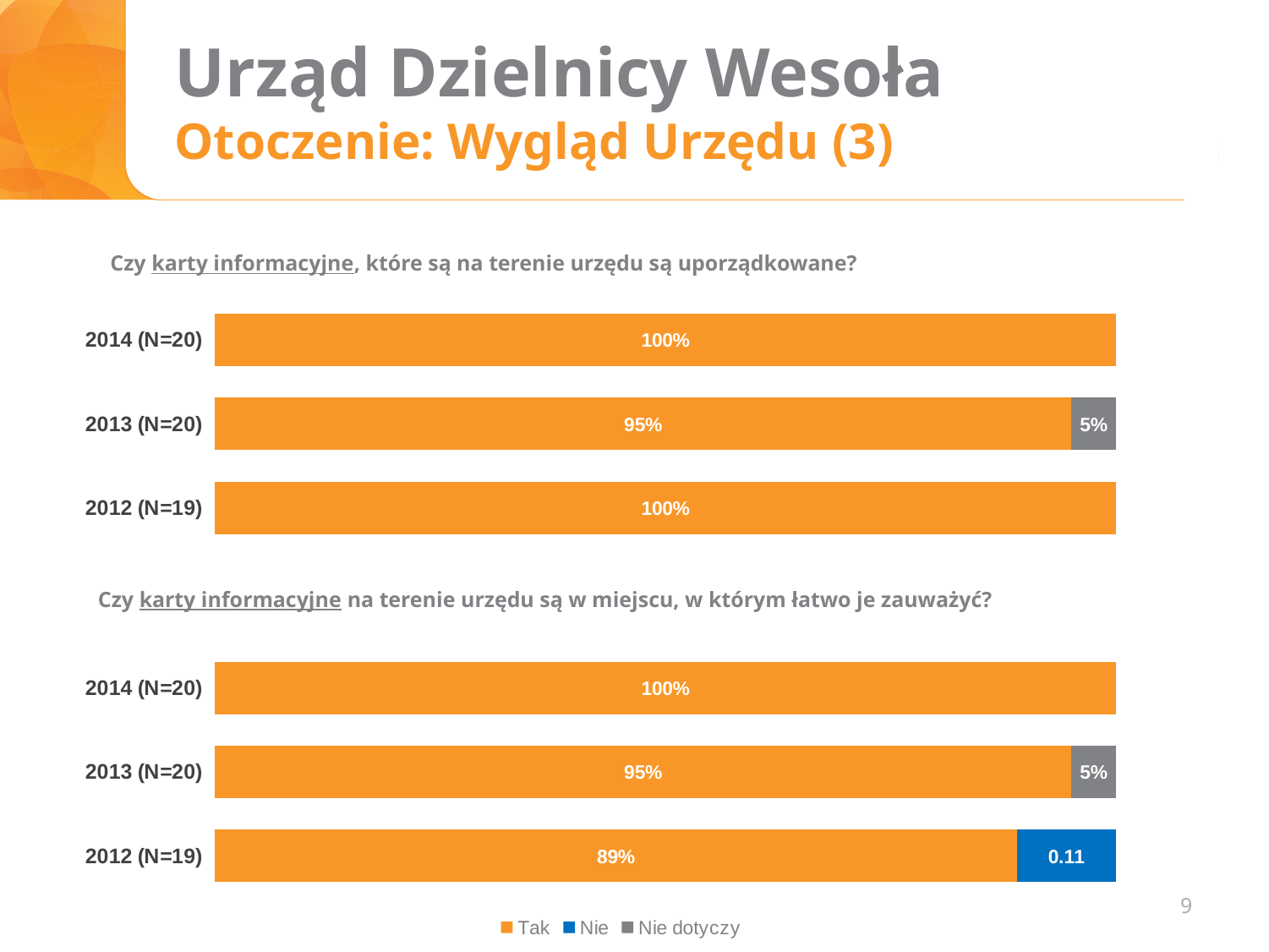
In the top chart ("Czy karty informacyjne, które są na terenie urzędu są uporządkowane?"), what is the value for Tak in 2013 (N=20)? 95% In the bottom chart ("Czy karty informacyjne na terenie urzędu są w miejscu, w którym łatwo je zauważyć?"), what is the value of the blue Nie segment in 2012 (N=19)? 0.11 In the top chart ("Czy karty informacyjne, które są na terenie urzędu są uporządkowane?"), what is the value for Tak in 2014 (N=20)? 100% In the top chart ("Czy karty informacyjne, które są na terenie urzędu są uporządkowane?"), is the Tak value for 2013 (N=20) larger or smaller than for 2014 (N=20)? smaller What are the three entries in the legend at the bottom of the slide? Tak, Nie, Nie dotyczy In the top chart ("Czy karty informacyjne, które są na terenie urzędu są uporządkowane?"), what is the value of the grey Nie dotyczy segment in 2013 (N=20)? 5% In the bottom chart ("Czy karty informacyjne na terenie urzędu są w miejscu, w którym łatwo je zauważyć?"), which year has the lowest Tak value? 2012 (N=19) How many year categories does the top chart ("Czy karty informacyjne, które są na terenie urzędu są uporządkowane?") show? 3 In the bottom chart ("Czy karty informacyjne na terenie urzędu są w miejscu, w którym łatwo je zauważyć?"), what is the difference between the Tak value in 2014 (N=20) and in 2012 (N=19)? 11% What type of chart is the bottom chart ("Czy karty informacyjne na terenie urzędu są w miejscu, w którym łatwo je zauważyć?")? Stacked horizontal bar chart How many series does the legend at the bottom of the slide list? 3 In the bottom chart ("Czy karty informacyjne na terenie urzędu są w miejscu, w którym łatwo je zauważyć?"), what is the value for Tak in 2012 (N=19)? 89%